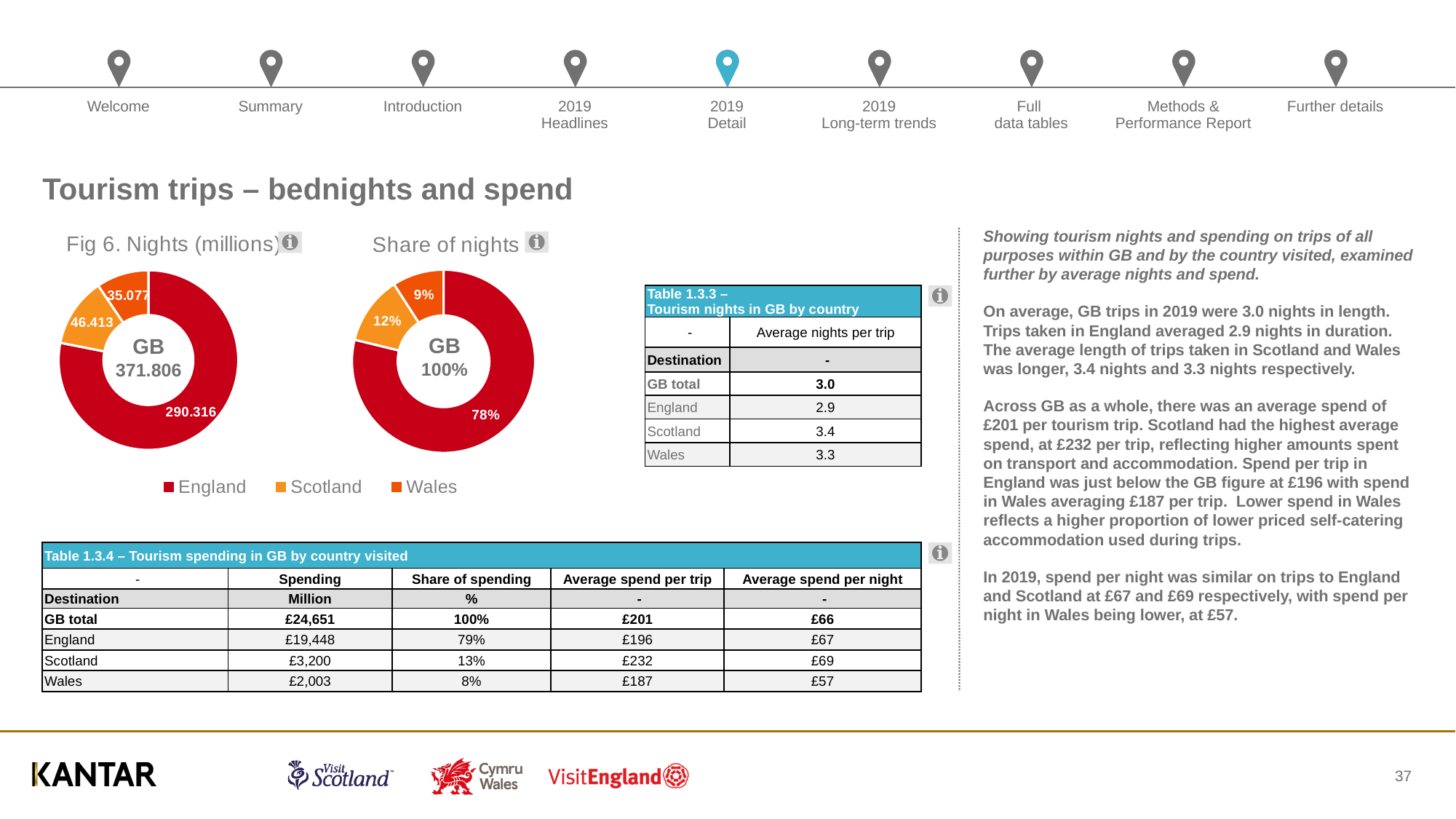
In the 'Share of nights' chart, what share does England have? 78% In the 'Fig 6. Nights (millions)' chart, what is the value for Scotland? 46.413 What kind of chart is 'Fig 6. Nights (millions)'? Donut (pie) chart In the 'Fig 6. Nights (millions)' chart, which country has the lowest number of nights? Wales In the 'Fig 6. Nights (millions)' chart, what is the GB total shown in the centre? 371.806 In the 'Fig 6. Nights (millions)' chart, which country has the highest number of nights? England How many countries does the legend below the two charts list? 3 In the 'Share of nights' chart, what share does Scotland have? 12% In the 'Fig 6. Nights (millions)' chart, what is the difference between the values for Scotland and Wales? 11.336 In the 'Fig 6. Nights (millions)' chart, what is the value for England? 290.316 In the 'Share of nights' chart, what share does Wales have? 9% In the 'Fig 6. Nights (millions)' chart, what is the value for Wales? 35.077